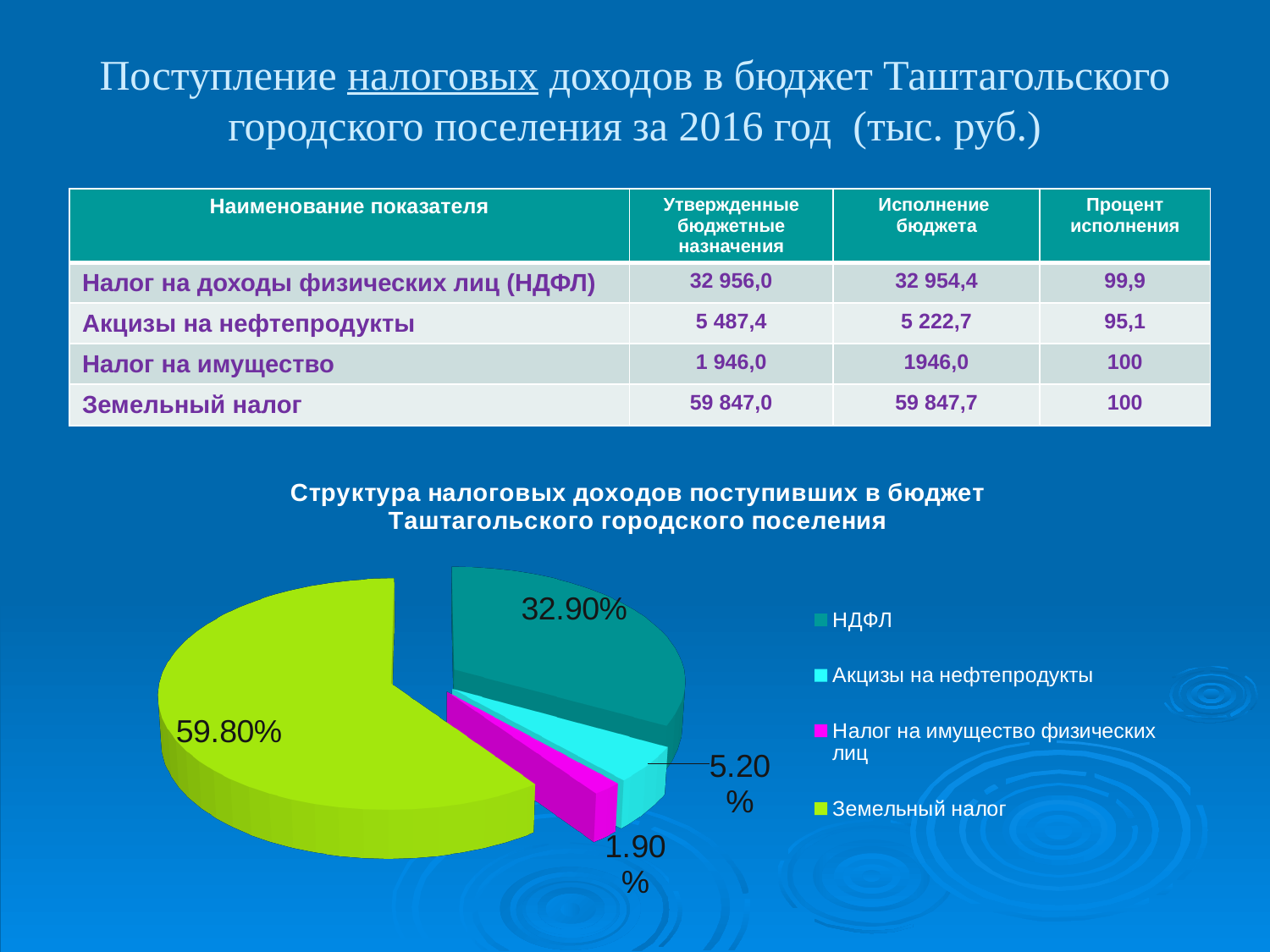
What share of the pie does Акцизы на нефтепродукты have? 5.20% What share of the pie does Налог на имущество физических лиц have? 1.90% What is the difference in percentage points between the Земельный налог slice and the НДФЛ slice? 26.90 How many entries does the legend of the pie chart list? 4 Which category has the smallest slice of the pie? Налог на имущество физических лиц What share of the pie does Земельный налог have? 59.80% Which slice is larger, Акцизы на нефтепродукты or Налог на имущество физических лиц? Акцизы на нефтепродукты What colour is the Земельный налог slice in the pie chart? green How many slices does the pie chart have? 4 Which category has the largest slice of the pie? Земельный налог What kind of chart is shown on the slide? pie chart